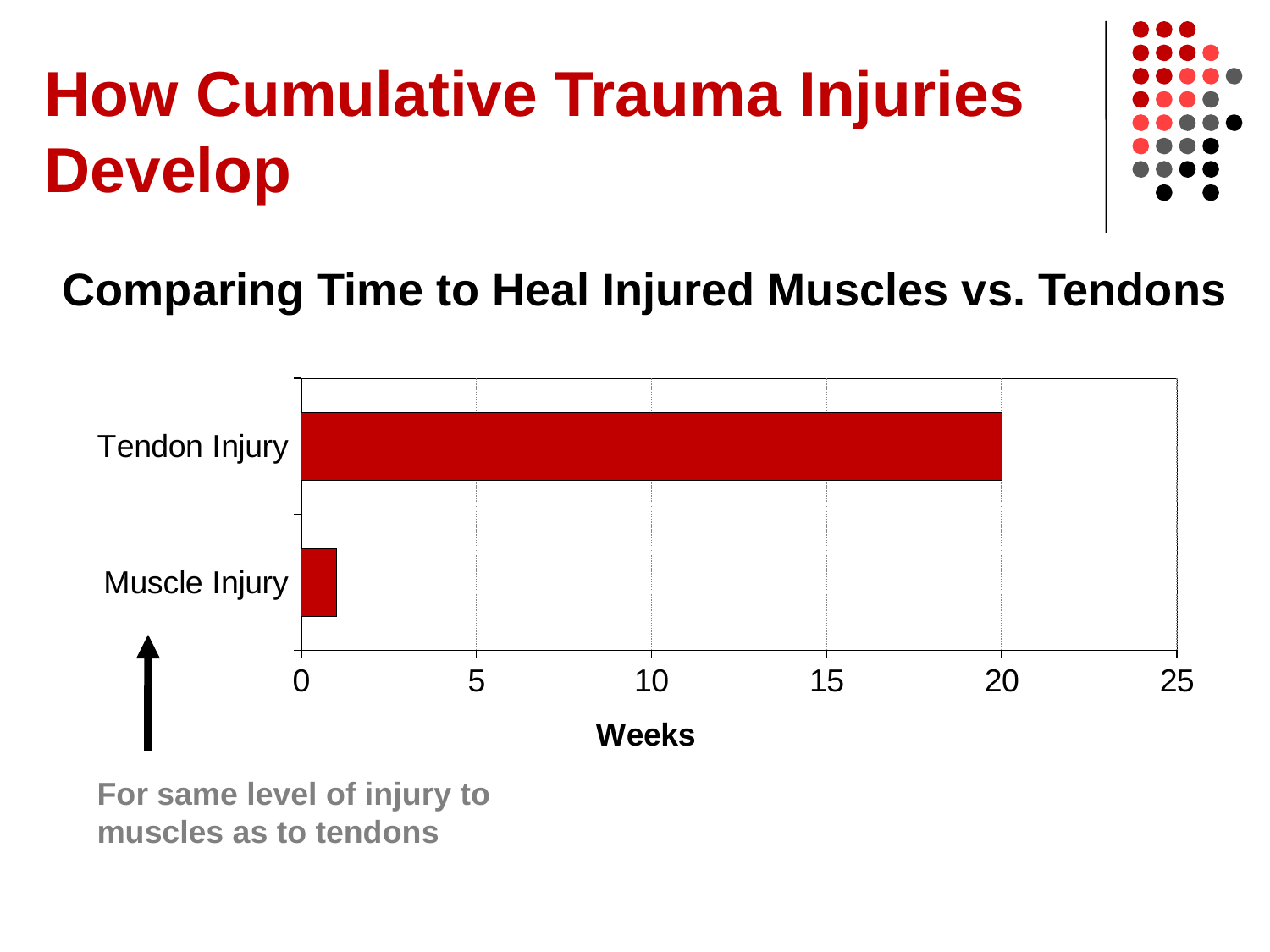
What is the label on the horizontal axis of the chart? Weeks Is the value for Muscle Injury greater or less than 5? less How many categories are plotted in the chart? 2 Is the value for Tendon Injury greater or less than 15? greater Which category has the lowest value in the chart? Muscle Injury Which category has the highest value in the chart? Tendon Injury What is the title of the chart? Comparing Time to Heal Injured Muscles vs. Tendons Is the value for Tendon Injury greater or less than 25? less Which is larger, the value for Tendon Injury or the value for Muscle Injury? Tendon Injury How many weeks does the chart show for Tendon Injury? 20 What kind of chart is shown on the slide? bar chart